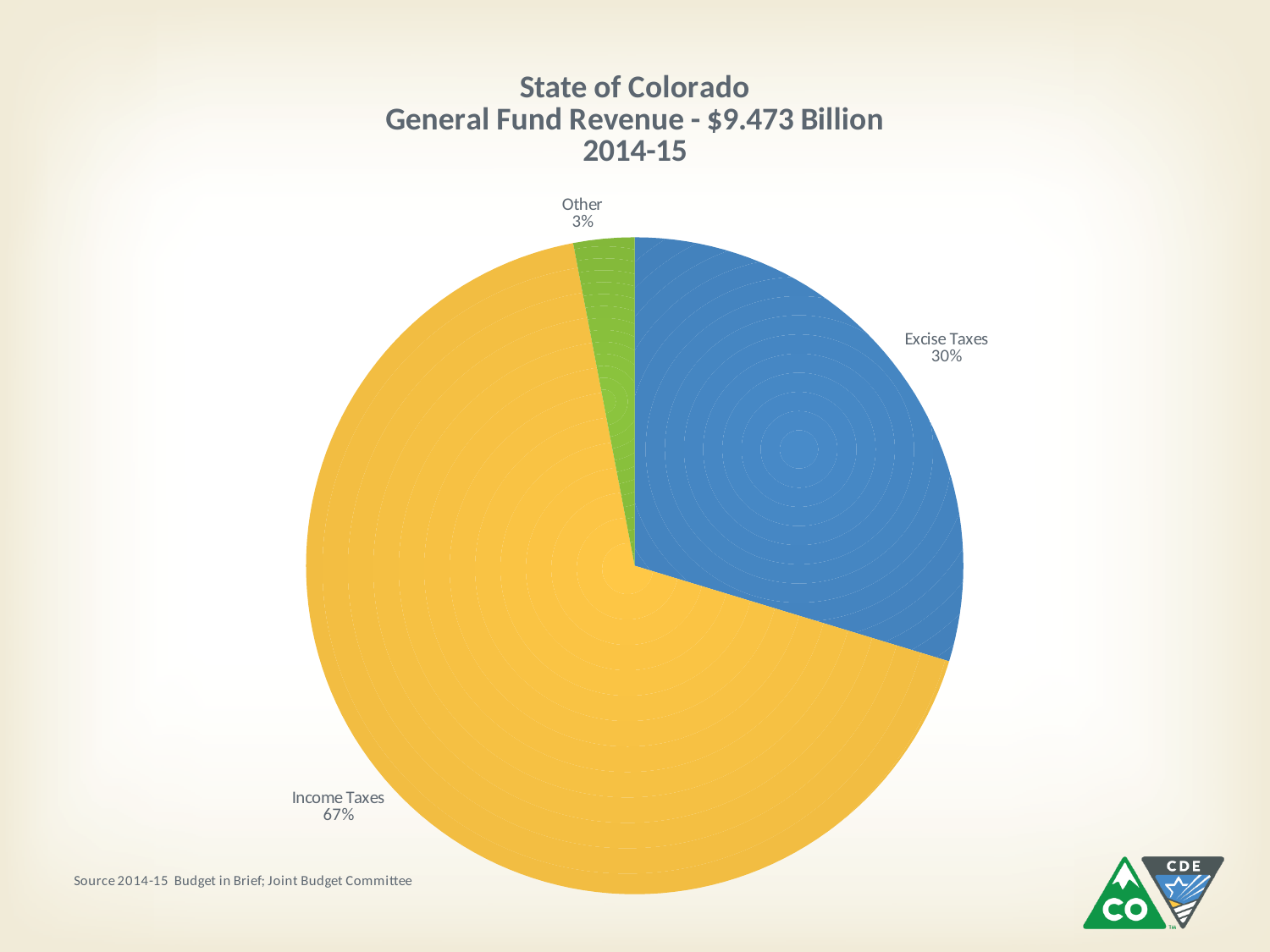
What share of General Fund Revenue is labelled Other? 3% Which fiscal year does the chart cover? 2014-15 Which category has the largest share of the pie? Income Taxes How many slices does the pie chart have? 3 What total General Fund Revenue amount is stated in the chart title? $9.473 Billion What kind of chart is shown on the slide? pie chart What is the difference in percentage points between the Income Taxes share and the Excise Taxes share? 37 Which category has the smallest share of the pie? Other What share of General Fund Revenue comes from Excise Taxes? 30% Which is larger, the Excise Taxes share or the Other share? Excise Taxes What share of General Fund Revenue comes from Income Taxes? 67%